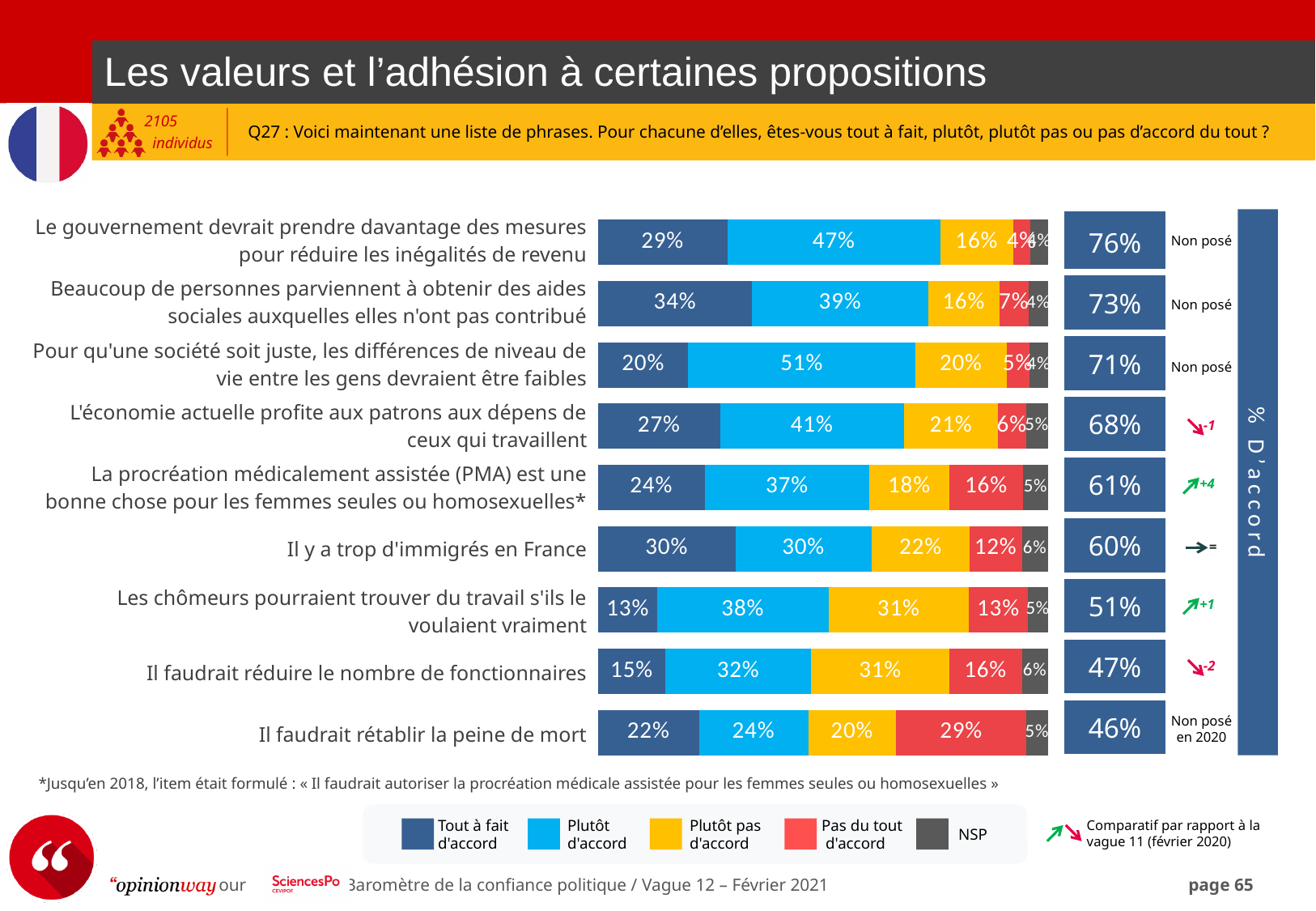
What type of chart is used on this slide? Stacked bar chart How many statements are shown in the chart? 9 What is the combined share of "Tout à fait d'accord" and "Plutôt d'accord" for "La procréation médicalement assistée (PMA)..."? 61% What percentage answered "Pas du tout d'accord" to "Il faudrait rétablir la peine de mort"? 29% Which has a larger "Plutôt d'accord" share: "Pour qu'une société soit juste..." or "Il faudrait réduire le nombre de fonctionnaires"? Pour qu'une société soit juste, les différences de niveau de vie entre les gens devraient être faibles Which colour represents "Plutôt pas d'accord" in the legend? Yellow Which statement has the highest "% D'accord" value? Le gouvernement devrait prendre davantage des mesures pour réduire les inégalités de revenu Which statement has the lowest "% D'accord" value? Il faudrait rétablir la peine de mort How many response categories does the legend list? 5 What is the "% D'accord" value for "Il faudrait rétablir la peine de mort"? 46% What is the difference between the "% D'accord" values for "Il y a trop d'immigrés en France" and "Les chômeurs pourraient trouver du travail s'ils le voulaient vraiment"? 9 points What percentage of respondents answered "Tout à fait d'accord" to "Il y a trop d'immigrés en France"? 30%